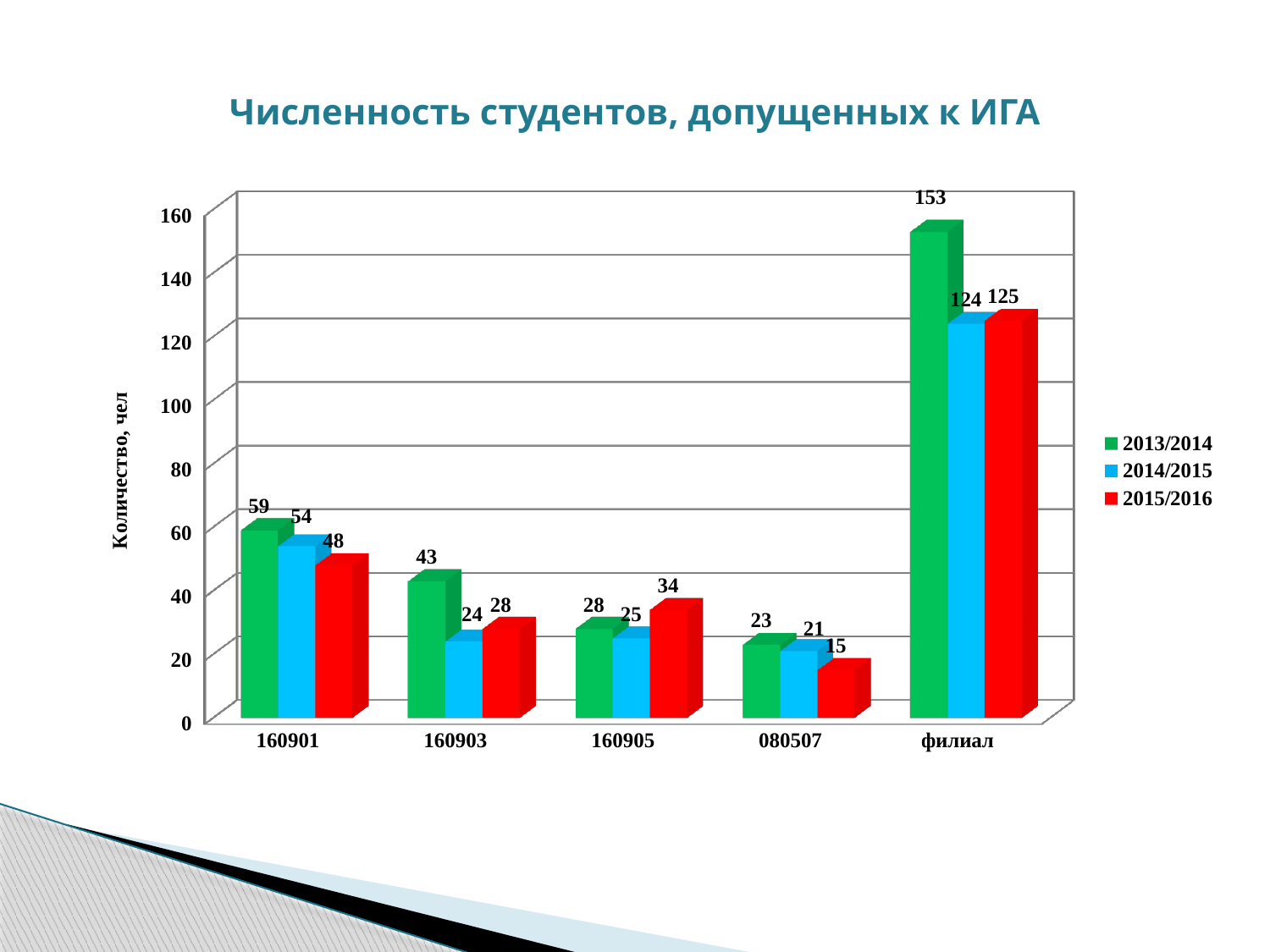
What is the value for 160901 in the 2013/2014 series? 59 Is the value for филиал in the 2013/2014 series greater or less than 140? greater What is the value for 080507 in the 2015/2016 series? 15 What is the value for филиал in the 2014/2015 series? 124 How many series does the legend list? 3 How many categories are shown on the x axis? 5 What is the difference between the 2013/2014 and 2015/2016 values for 160903? 15 Which is larger for 160905: the 2014/2015 value or the 2015/2016 value? 2015/2016 Which category has the lowest value in the 2015/2016 series? 080507 What is the title of the chart? Численность студентов, допущенных к ИГА What kind of chart is shown on the slide? bar chart Which category has the highest value in the 2013/2014 series? филиал